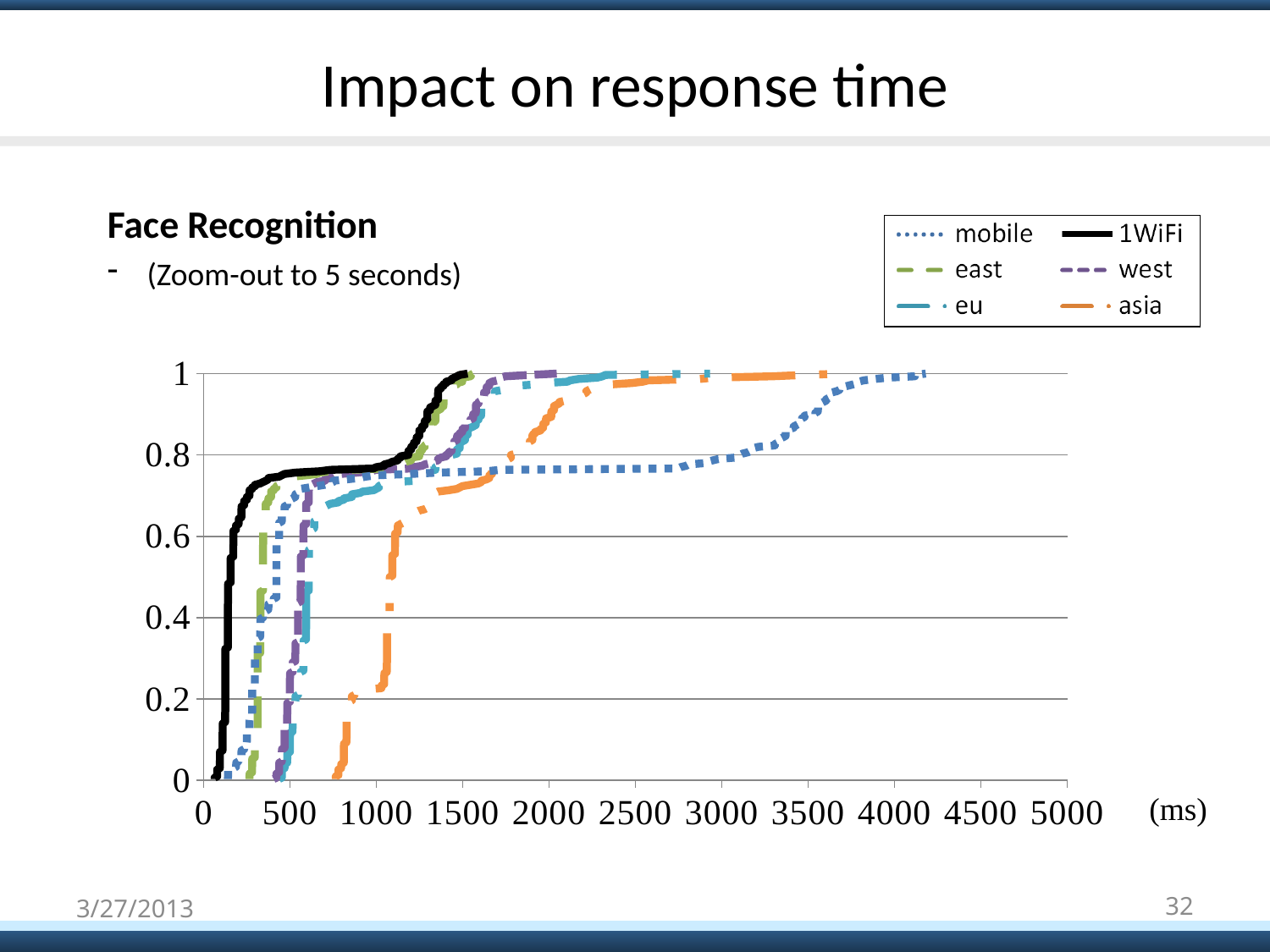
Is the value of the mobile curve at 2500 ms greater or less than 0.8? less Which series is drawn as a solid black line? 1WiFi Which series reaches 1 at the largest response time? mobile Which series starts rising at the largest response time? asia Which series reaches 1 at the smallest response time? 1WiFi Is the value of the 1WiFi curve at 500 ms greater or less than 0.6? greater How many series does the legend list? 6 Do the curves rise or fall as the x axis increases? rise Is the value of the asia curve at 1000 ms greater or less than 0.4? less What unit is shown on the x axis? ms What kind of chart is shown on the slide? line chart What is the highest tick value on the x axis? 5000